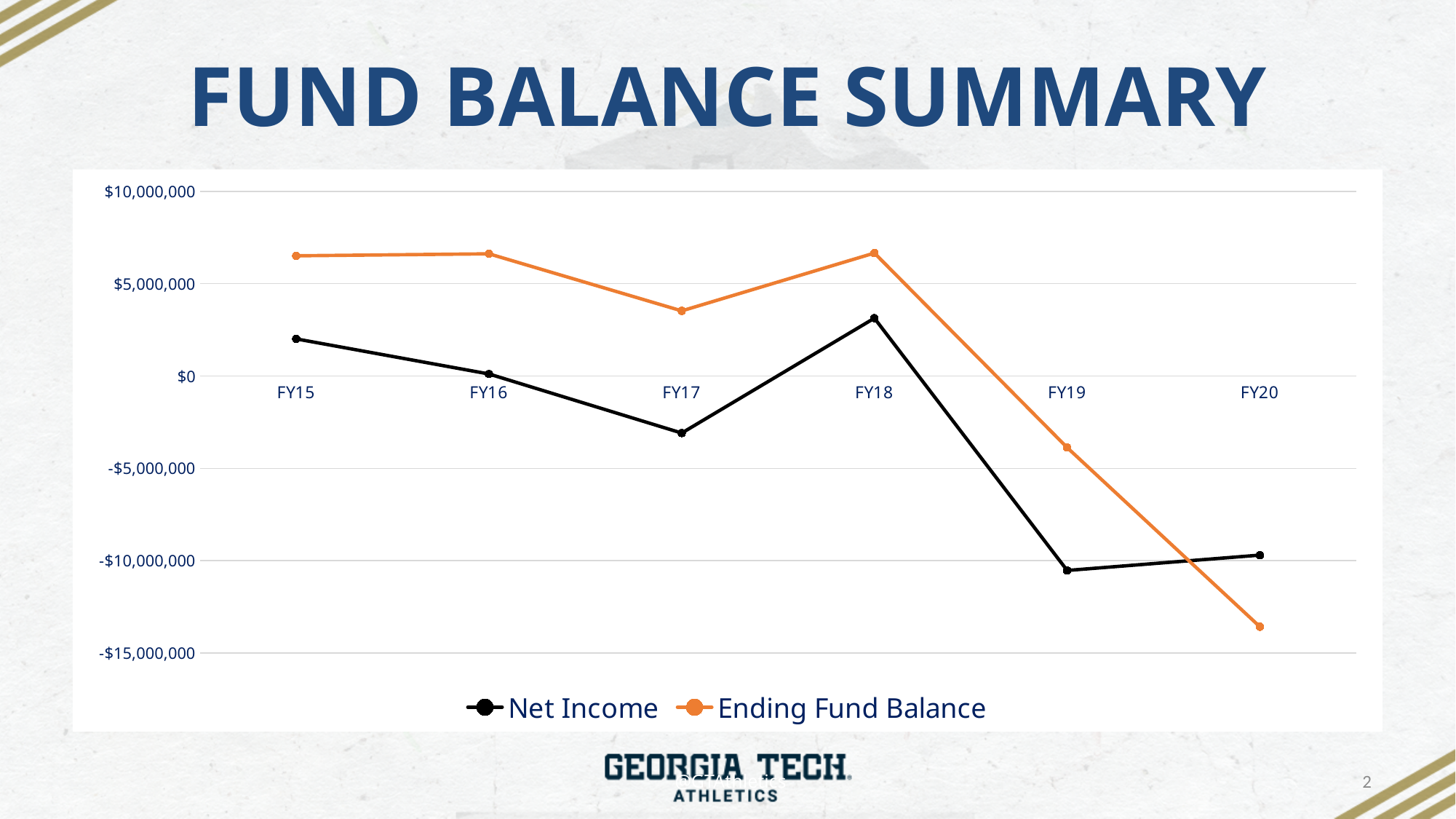
How many fiscal years are plotted along the x axis? 6 How many series does the legend list? 2 In which fiscal year is Net Income highest? FY18 In FY20, which is larger: Net Income or Ending Fund Balance? Net Income In which fiscal year is the Ending Fund Balance lowest? FY20 Which series is drawn in orange? Ending Fund Balance What kind of chart is shown on the slide? Line chart What is the title of the slide containing the chart? FUND BALANCE SUMMARY Does the Ending Fund Balance rise or fall from FY18 to FY20? Fall Is the Ending Fund Balance for FY20 greater or less than -$10,000,000? less Is the Net Income for FY17 greater or less than $0? less Is the Ending Fund Balance for FY17 greater or less than $5,000,000? less